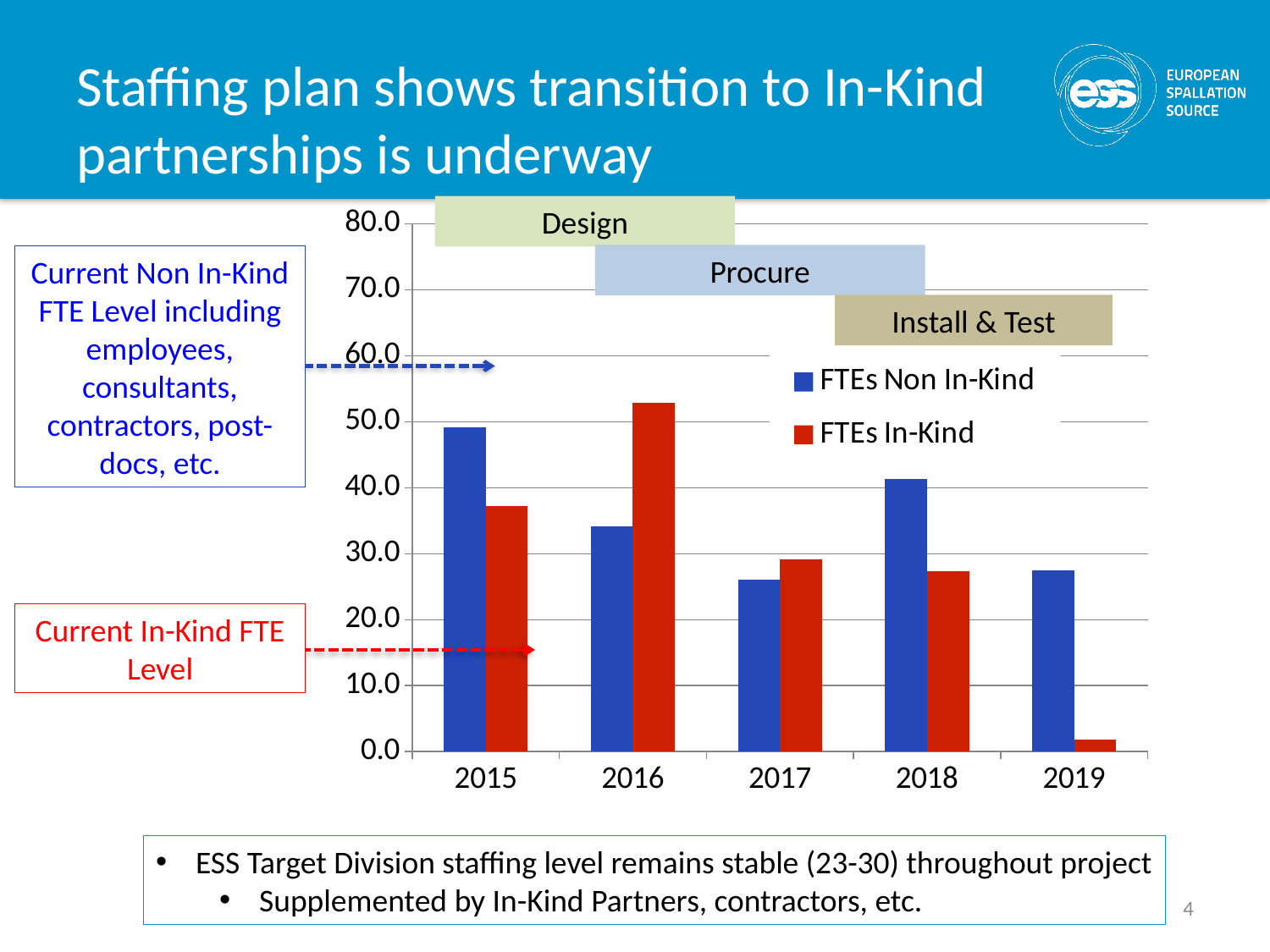
Is the FTEs In-Kind value for 2019 greater or less than 10.0? less In 2016, which is larger: FTEs Non In-Kind or FTEs In-Kind? FTEs In-Kind Do the FTEs In-Kind values rise or fall from 2016 to 2019? fall In which year is the FTEs In-Kind value highest? 2016 What kind of chart is shown on the slide? bar chart How many series does the chart legend list? 2 In 2015, which is larger: FTEs Non In-Kind or FTEs In-Kind? FTEs Non In-Kind In which year is the FTEs Non In-Kind value highest? 2015 What are the three project phases labelled above the chart? Design, Procure, Install & Test How many years are shown on the x axis of the chart? 5 Is the FTEs In-Kind value for 2016 greater or less than 50.0? greater In which year is the FTEs In-Kind value lowest? 2019